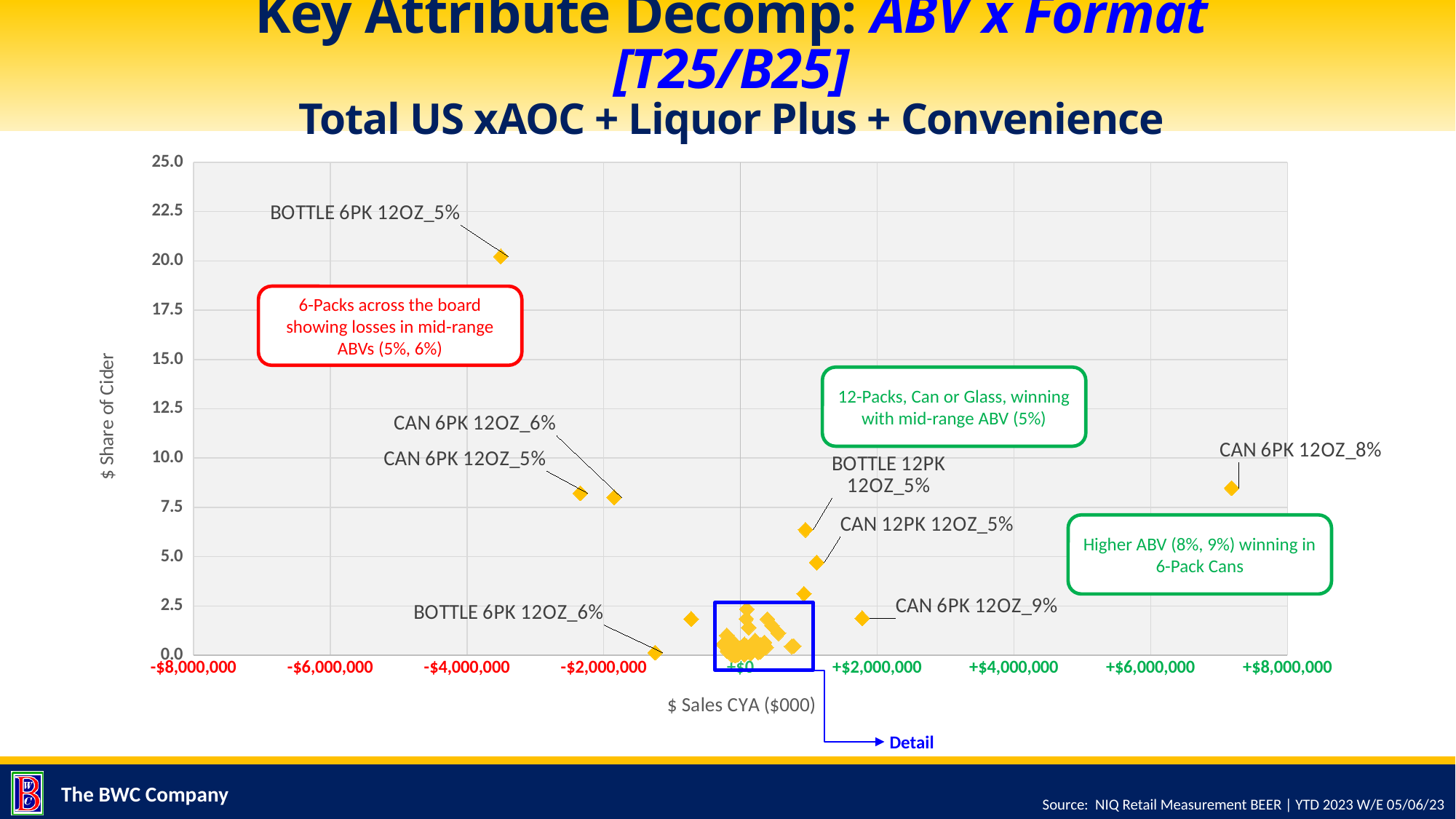
Is the $ Share of Cider for BOTTLE 6PK 12OZ_5% greater or less than 17.5? greater Is the $ Sales CYA for CAN 6PK 12OZ_5% greater or less than -$2,000,000? less Is the $ Share of Cider for CAN 12PK 12OZ_5% greater or less than 5.0? less What is the title of the horizontal axis? $ Sales CYA ($000) Which labeled point has the highest $ Sales CYA ($000)? CAN 6PK 12OZ_8% Which has a higher $ Share of Cider, BOTTLE 12PK 12OZ_5% or CAN 6PK 12OZ_9%? BOTTLE 12PK 12OZ_5% What kind of chart is shown on the slide? Scatter chart Which has a higher $ Share of Cider, CAN 6PK 12OZ_8% or BOTTLE 6PK 12OZ_6%? CAN 6PK 12OZ_8% What is the title of the vertical axis? $ Share of Cider Which labeled point has the highest $ Share of Cider? BOTTLE 6PK 12OZ_5% Which labeled point has the lowest $ Sales CYA ($000)? BOTTLE 6PK 12OZ_5%